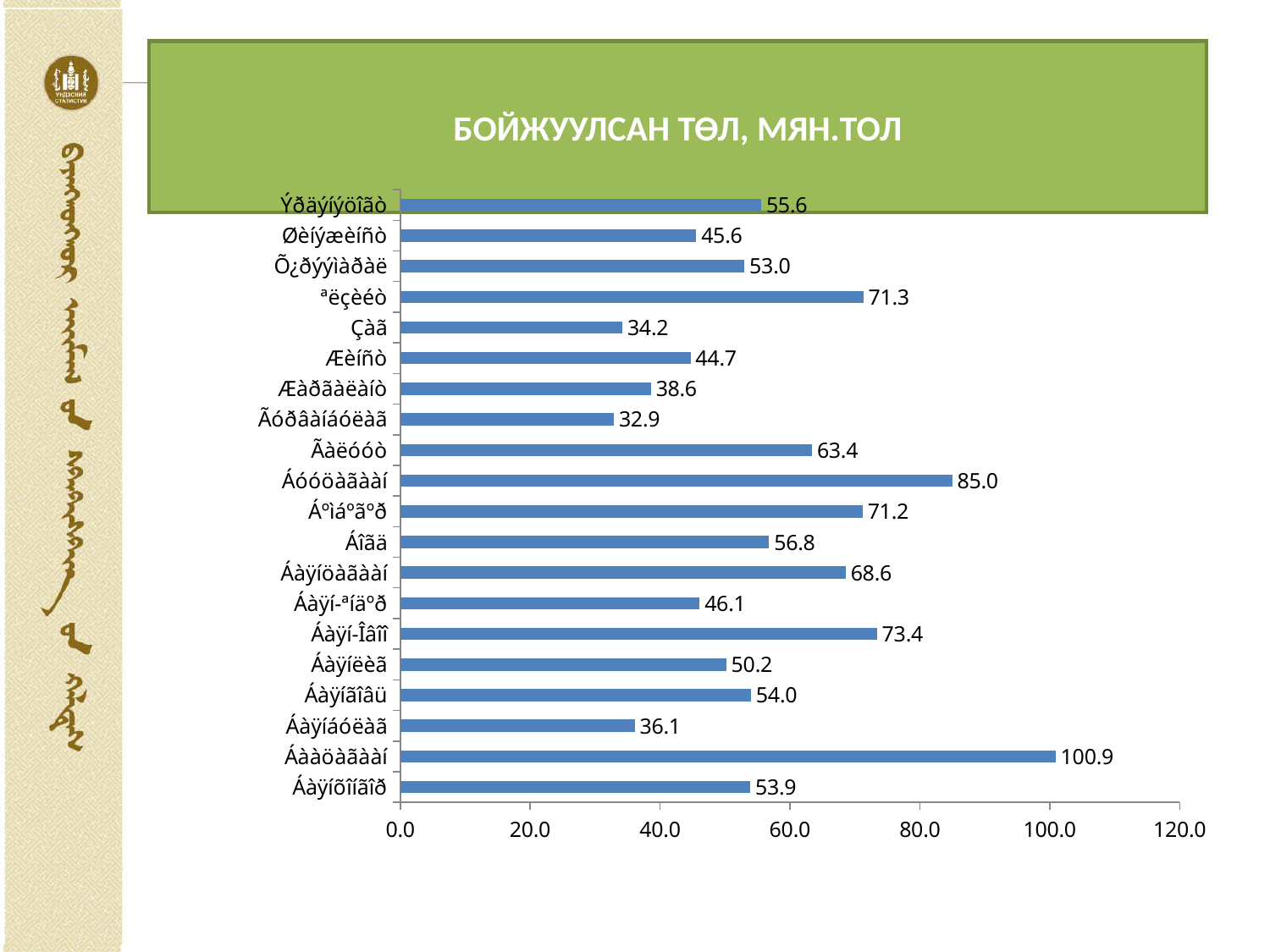
What is the value of the bottom bar in the chart? 53.9 How many bars (categories) does the chart show? 20 How many bars have a value above 80.0? 2 What is the value of the topmost bar in the chart? 55.6 What is the title of the chart? БОЙЖУУЛСАН ТӨЛ, МЯН.ТОЛ Which is larger, the value of the topmost bar or the value of the bottom bar? the topmost bar (55.6) What is the difference between the highest and lowest values in the chart? 68.0 What is the highest value shown in the chart? 100.9 What is the lowest value shown in the chart? 32.9 Is the longest bar in the chart greater or less than 100.0? greater What is the value of the second bar from the bottom? 100.9 What kind of chart is shown on the slide? bar chart